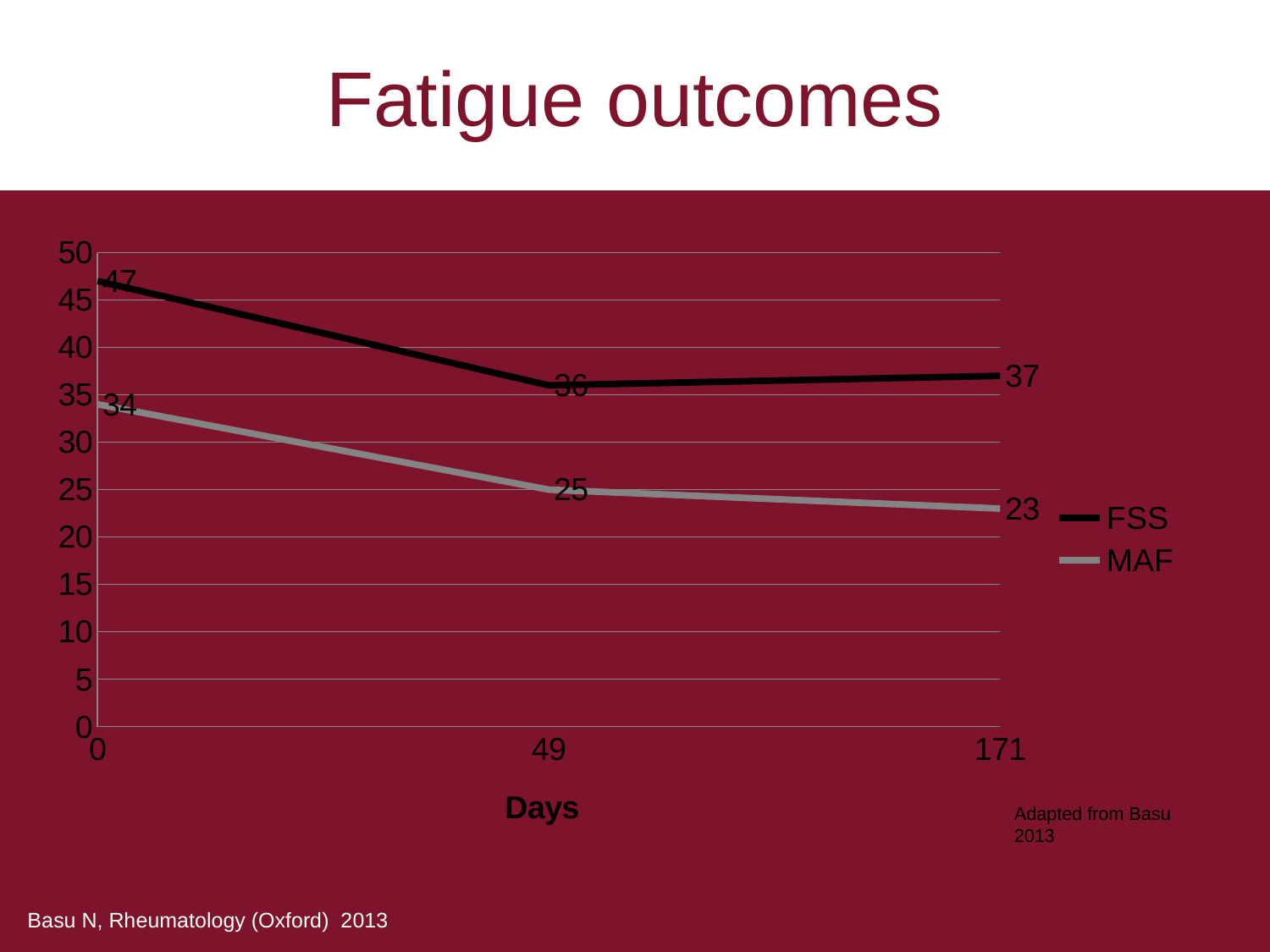
Which series has the larger value at day 49, FSS or MAF? FSS What is the difference between the FSS value at day 0 and at day 49? 11 What is the MAF value at day 49? 25 What is the FSS value at day 0? 47 What is the difference between the FSS and MAF values at day 171? 14 What is the MAF value at day 171? 23 How many series does the legend list? 2 At which day is the MAF value highest? 0 What kind of chart is shown on the slide? Line chart At which day is the FSS value lowest? 49 What is the FSS value at day 171? 37 Does the MAF series rise or fall from day 0 to day 171? Fall